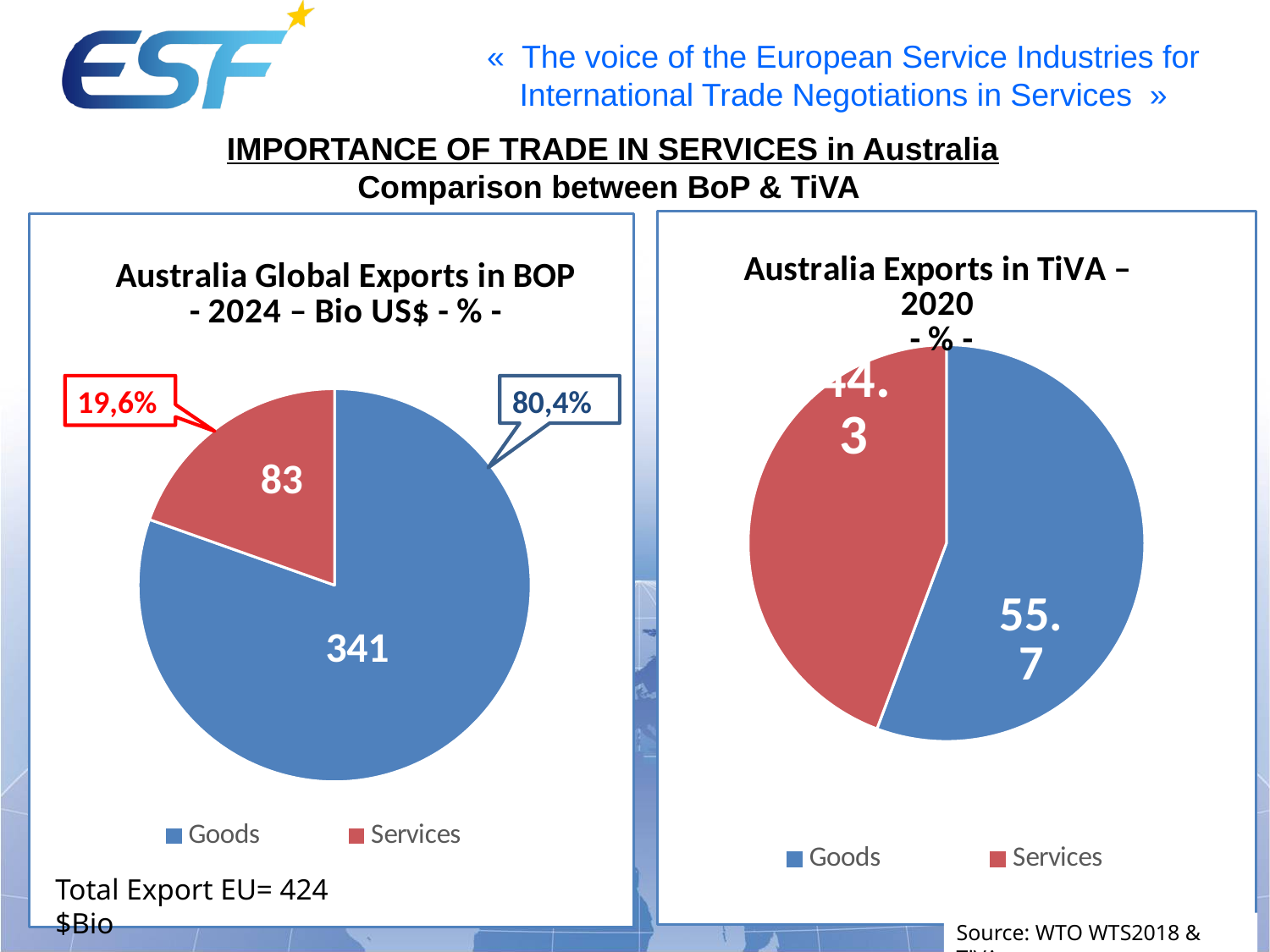
In the right chart, Australia Exports in TiVA 2020, which category is the smallest? Services In the right chart, Australia Exports in TiVA 2020, is the value for Goods larger or smaller than the value for Services? larger How many categories does the legend of the right chart, Australia Exports in TiVA 2020, list? 2 What kind of chart is the left chart, Australia Global Exports in BOP 2024? pie chart In the left chart, Australia Global Exports in BOP 2024, which category is the largest? Goods In the left chart, Australia Global Exports in BOP 2024, what percentage share does Services have? 19,6% In the left chart, Australia Global Exports in BOP 2024, what percentage share does Goods have? 80,4% In the left chart, Australia Global Exports in BOP 2024, what is the value for Services? 83 In the left chart, Australia Global Exports in BOP 2024, what is the value for Goods? 341 In the right chart, Australia Exports in TiVA 2020, what is the value for Goods? 55.7 In the left chart, Australia Global Exports in BOP 2024, what colour is the Services slice? red In the left chart, Australia Global Exports in BOP 2024, what is the difference between the Goods and Services values? 258